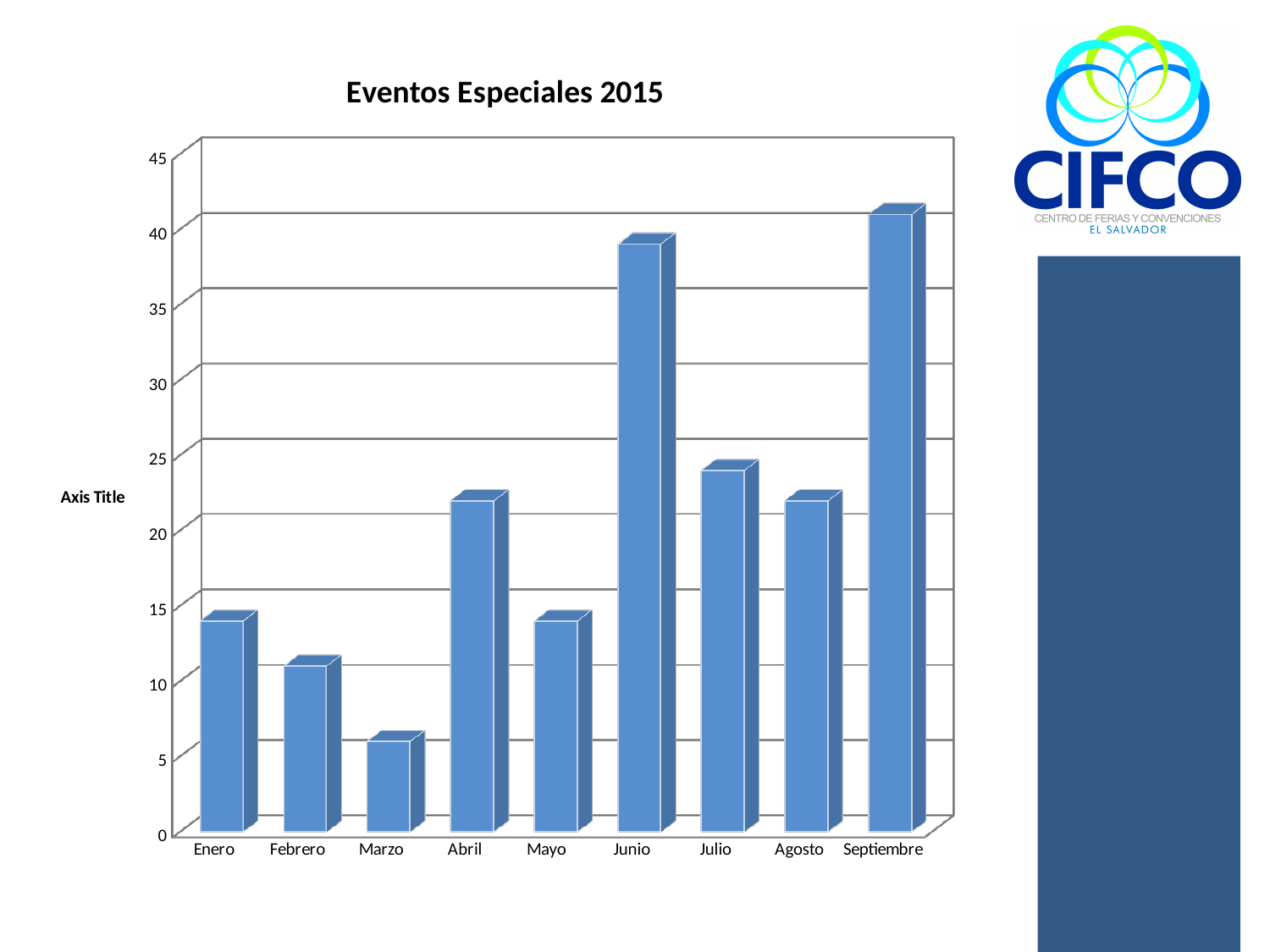
Is the value for Junio greater or less than 35? greater Is the value for Febrero greater or less than 15? less Is the value for Marzo greater or less than 10? less Which is larger, the value for Junio or the value for Julio? Junio Which is larger, the value for Enero or the value for Febrero? Enero Which month has the lowest value? Marzo What is the title of the chart? Eventos Especiales 2015 Which month has the highest value? Septiembre What type of chart is shown on the slide? Bar chart How many months (categories) are shown on the x axis? 9